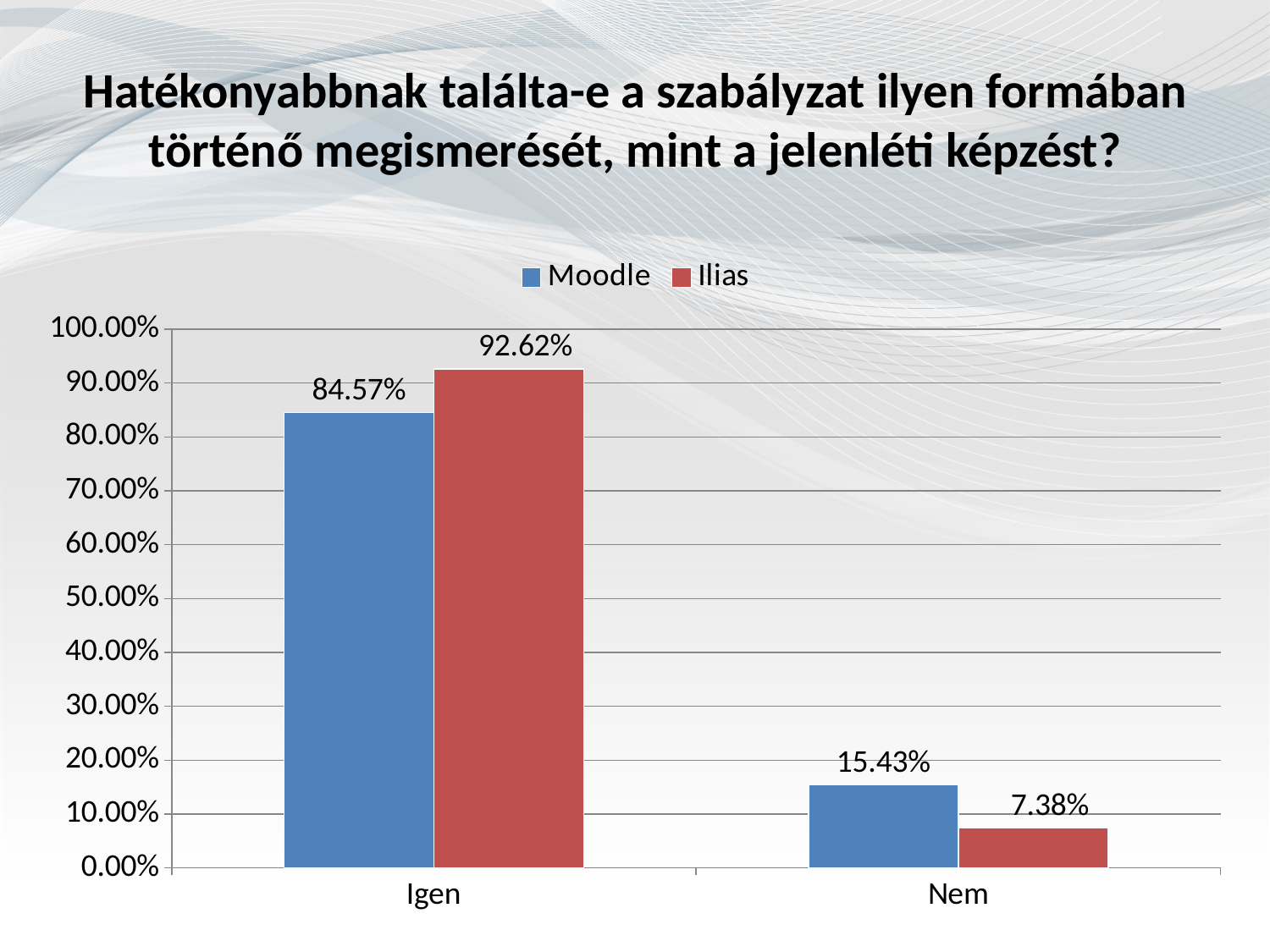
What is the Moodle value for Igen? 84.57% What kind of chart is shown on the slide? bar chart Which category has the highest Ilias value? Igen What is the difference between the Moodle and Ilias values for Nem? 8.05% What is the Ilias value for Igen? 92.62% Which category has the lowest Moodle value? Nem For Nem, which series has the larger value, Moodle or Ilias? Moodle What is the Ilias value for Nem? 7.38% How many categories are shown on the x axis? 2 What is the difference between the Ilias and Moodle values for Igen? 8.05% What is the Moodle value for Nem? 15.43% How many series does the legend list? 2